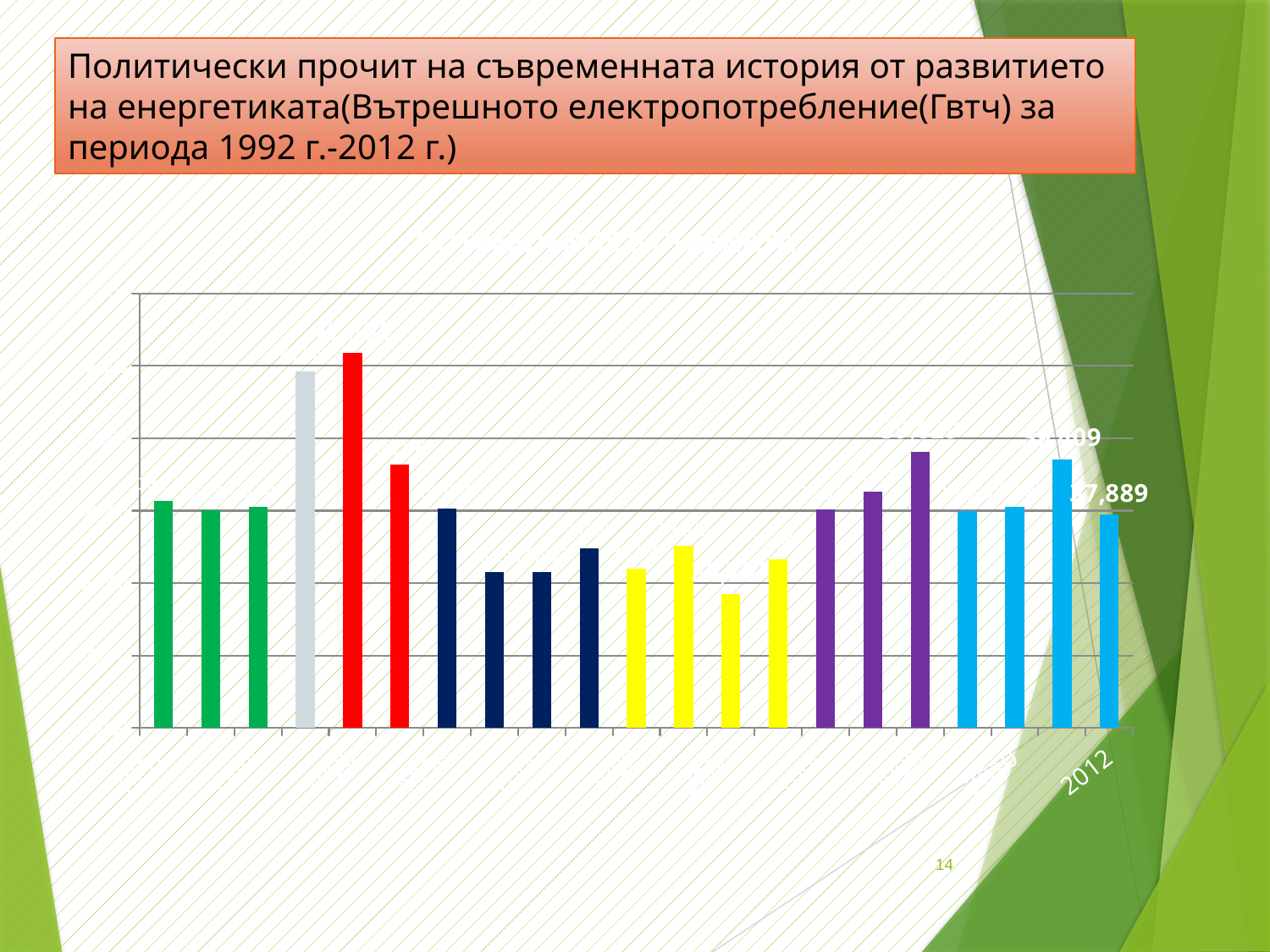
Moving from the tallest red bar to the shortest yellow bar, do the values generally rise or fall? fall What colour is the shortest bar in the chart? yellow Moving from the shortest yellow bar to the tallest purple bar, do the values generally rise or fall? rise Which year is labelled under the rightmost bar of the chart? 2012 How many bars are plotted in the chart? 21 Is the bar for 2012 taller or shorter than the tallest red bar? shorter What kind of chart is shown on the slide? bar chart What colour is the tallest bar in the chart? red